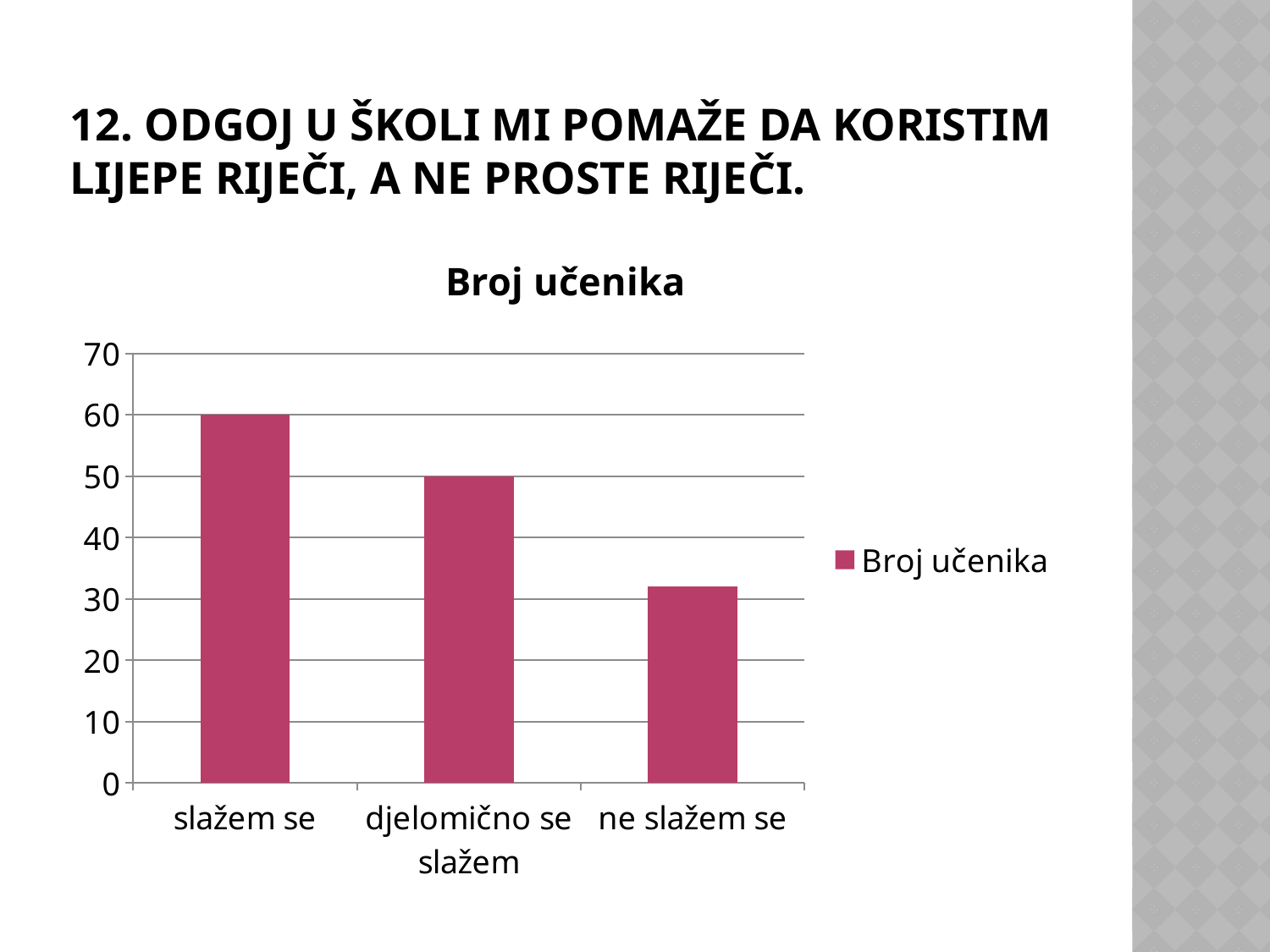
Is the value for 'ne slažem se' greater or less than 40? less What is the value for 'slažem se'? 60 Is the value for 'ne slažem se' greater or less than 30? greater Do the values rise or fall from left to right along the x axis? fall Which category has the lowest value? ne slažem se Which category has the highest value? slažem se What is the difference between the values for 'slažem se' and 'djelomično se slažem'? 10 What is the value for 'djelomično se slažem'? 50 What is the title of the chart? Broj učenika How many series does the legend list? 1 What kind of chart is shown on the slide? bar chart How many categories are shown on the x axis of the chart? 3